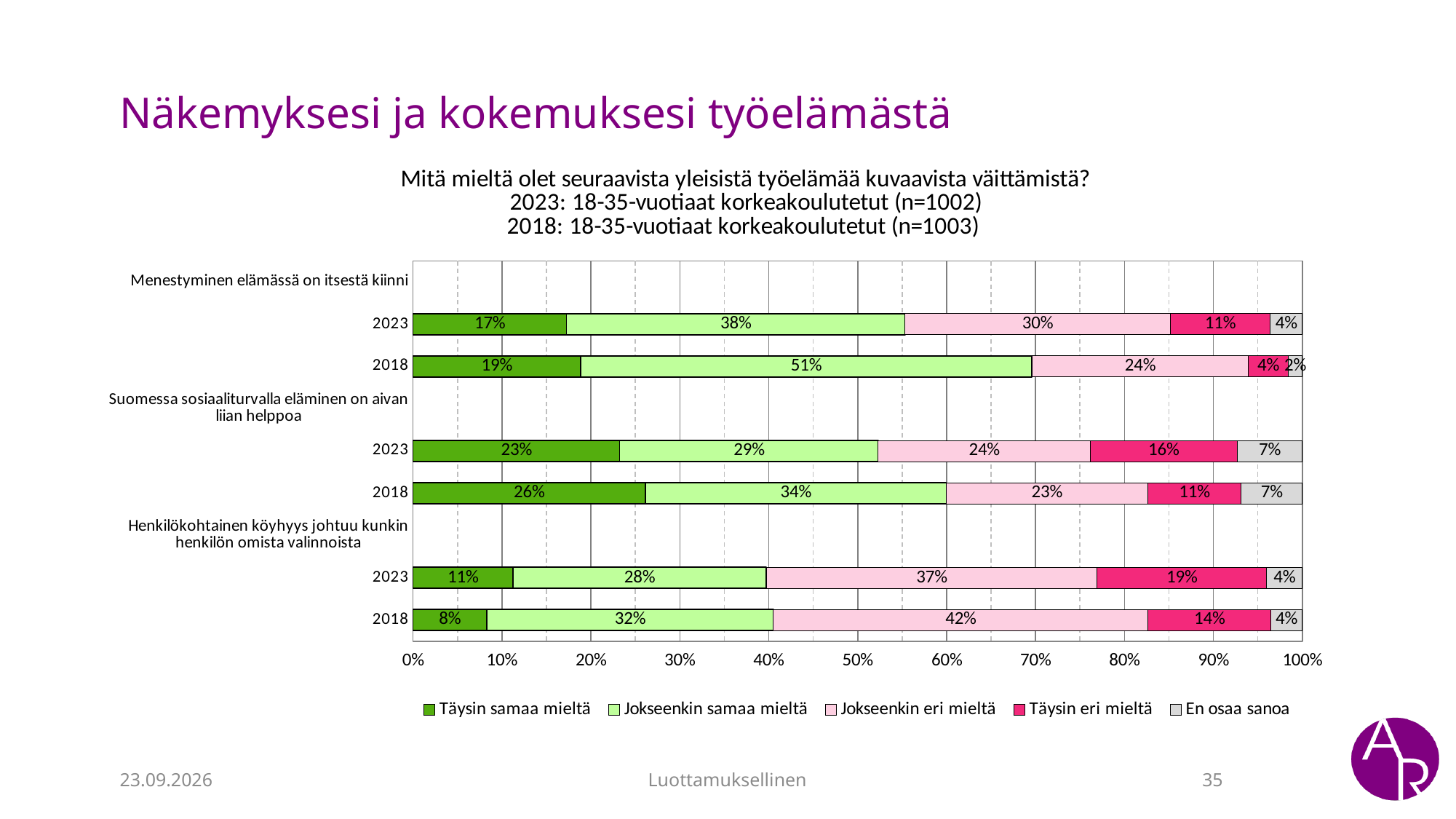
How many bars are plotted in the chart? 6 Which bar has the highest 'Täysin samaa mieltä' value? Suomessa sosiaaliturvalla eläminen on aivan liian helppoa, 2018 What is the 'Jokseenkin samaa mieltä' value for 'Menestyminen elämässä on itsestä kiinni' in 2018? 51% What is the 'Jokseenkin eri mieltä' value for 'Henkilökohtainen köyhyys johtuu kunkin henkilön omista valinnoista' in 2018? 42% What kind of chart is shown on the slide? Stacked bar chart What is the 'Täysin samaa mieltä' value for 'Menestyminen elämässä on itsestä kiinni' in 2023? 17% Which year has the larger 'Täysin samaa mieltä' share for 'Henkilökohtainen köyhyys johtuu kunkin henkilön omista valinnoista', 2023 or 2018? 2023 What is the 'Täysin eri mieltä' value for 'Suomessa sosiaaliturvalla eläminen on aivan liian helppoa' in 2023? 16% What is the 'En osaa sanoa' value for 'Suomessa sosiaaliturvalla eläminen on aivan liian helppoa' in 2018? 7% Which bar has the lowest 'Täysin eri mieltä' value? Menestyminen elämässä on itsestä kiinni, 2018 How many series does the legend list? 5 What is the difference between the 'Jokseenkin samaa mieltä' values for 'Menestyminen elämässä on itsestä kiinni' in 2018 and 2023? 13 percentage points